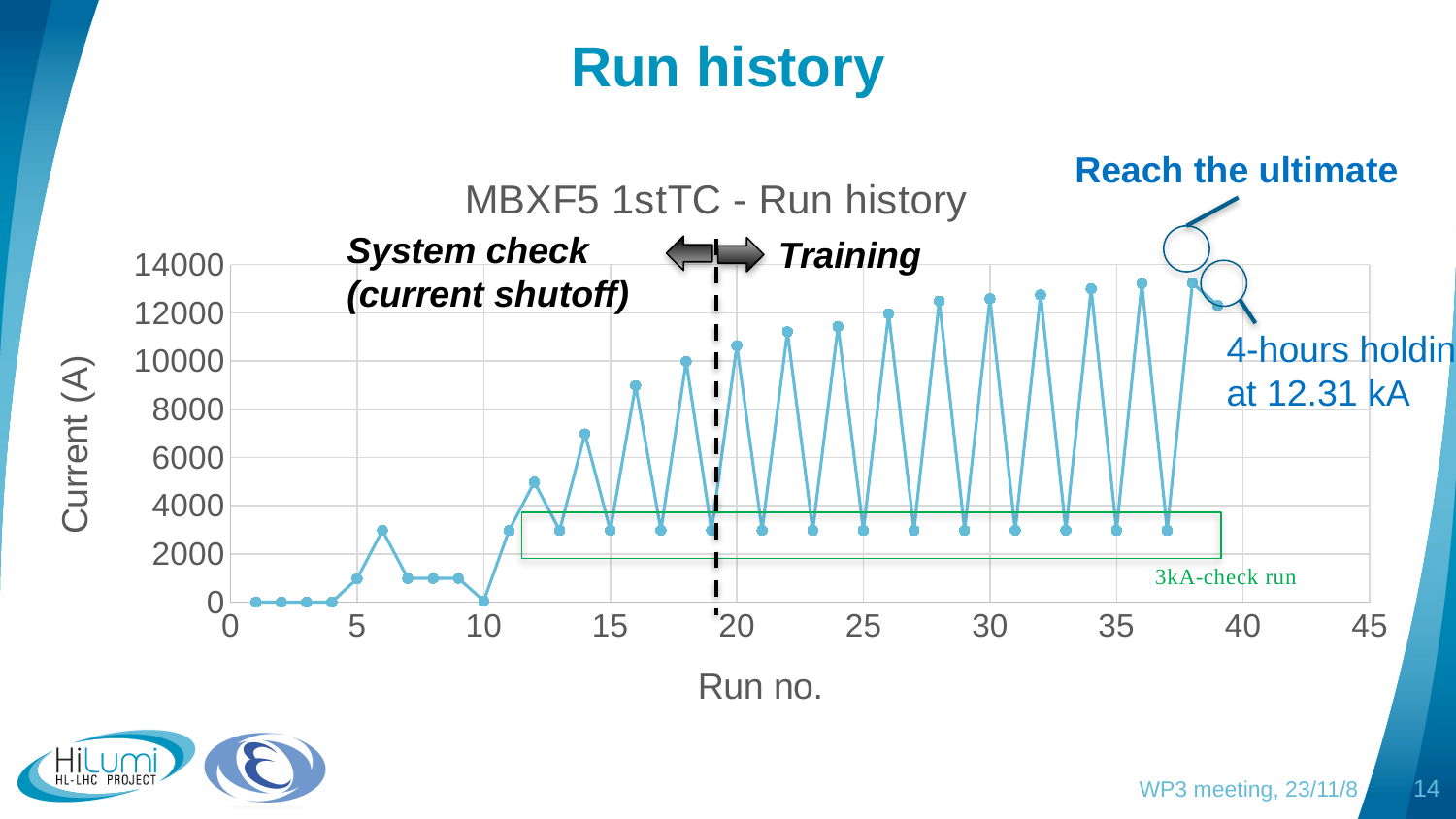
Do the peak currents rise or fall from run 20 to run 38? rise What is the label of the vertical axis of the chart? Current (A) Which has the higher current, run 12 or run 14? Run 14 Is the current for run 12 greater or less than 4000? greater What kind of chart is shown on the slide? Line chart Is the current for run 13 greater or less than 4000? less Is the current for run 16 greater or less than 8000? greater What is the current for run 1? 0 What is the title of the chart? MBXF5 1stTC - Run history